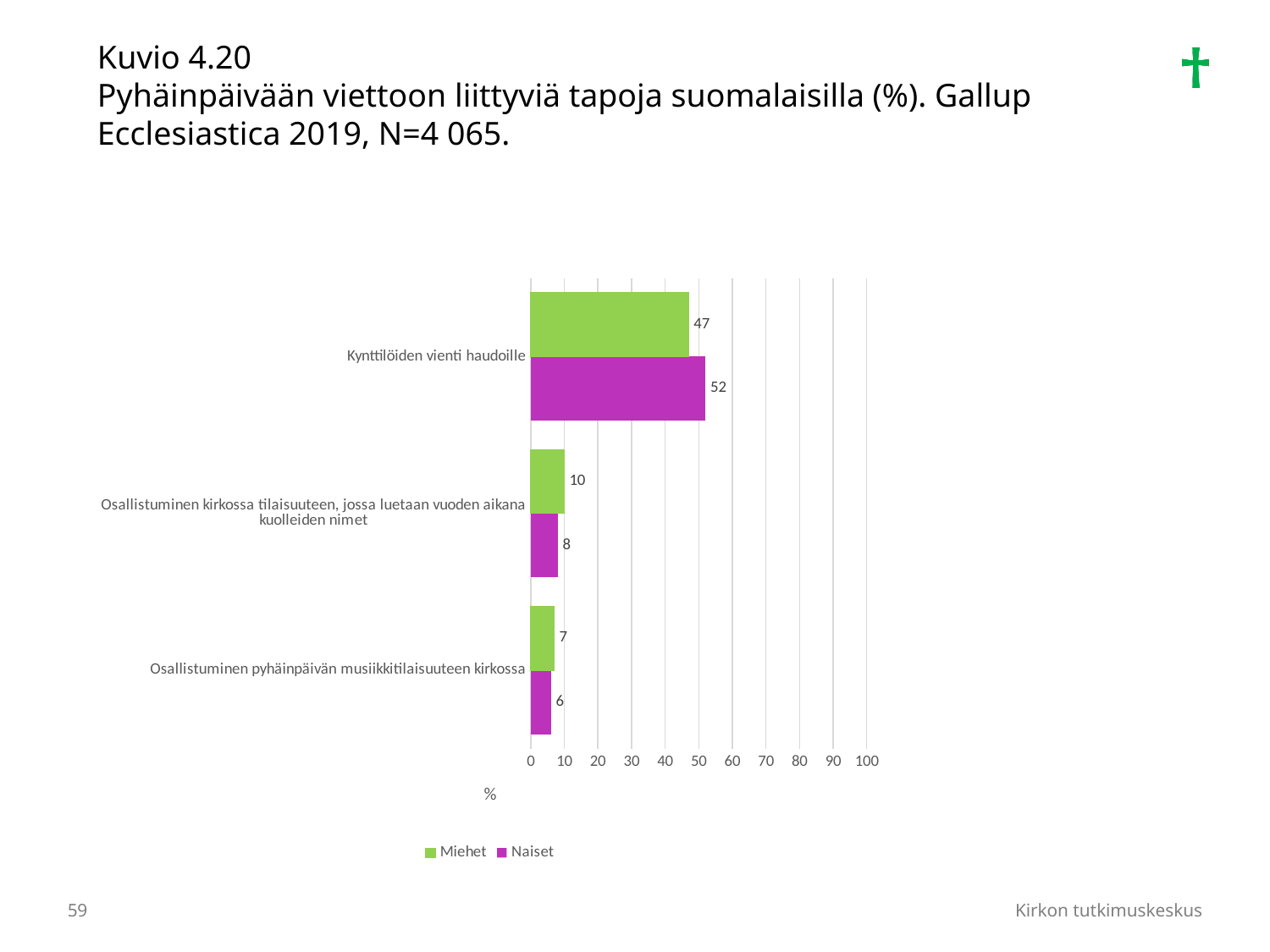
What is the value for Naiset for 'Osallistuminen pyhäinpäivän musiikkitilaisuuteen kirkossa'? 6 How many series does the legend list? 2 Which category has the lowest value for Miehet? Osallistuminen pyhäinpäivän musiikkitilaisuuteen kirkossa What is the value for Naiset for 'Kynttilöiden vienti haudoille'? 52 What is the value for Miehet for 'Kynttilöiden vienti haudoille'? 47 How many categories are shown on the chart? 3 Is the Naiset value for 'Kynttilöiden vienti haudoille' greater or less than 50? greater What is the difference between the Naiset and Miehet values for 'Kynttilöiden vienti haudoille'? 5 What kind of chart is shown on the slide? Bar chart Which category has the highest value for Naiset? Kynttilöiden vienti haudoille For 'Osallistuminen kirkossa tilaisuuteen, jossa luetaan vuoden aikana kuolleiden nimet', which is larger: Miehet or Naiset? Miehet What is the value for Miehet for 'Osallistuminen kirkossa tilaisuuteen, jossa luetaan vuoden aikana kuolleiden nimet'? 10